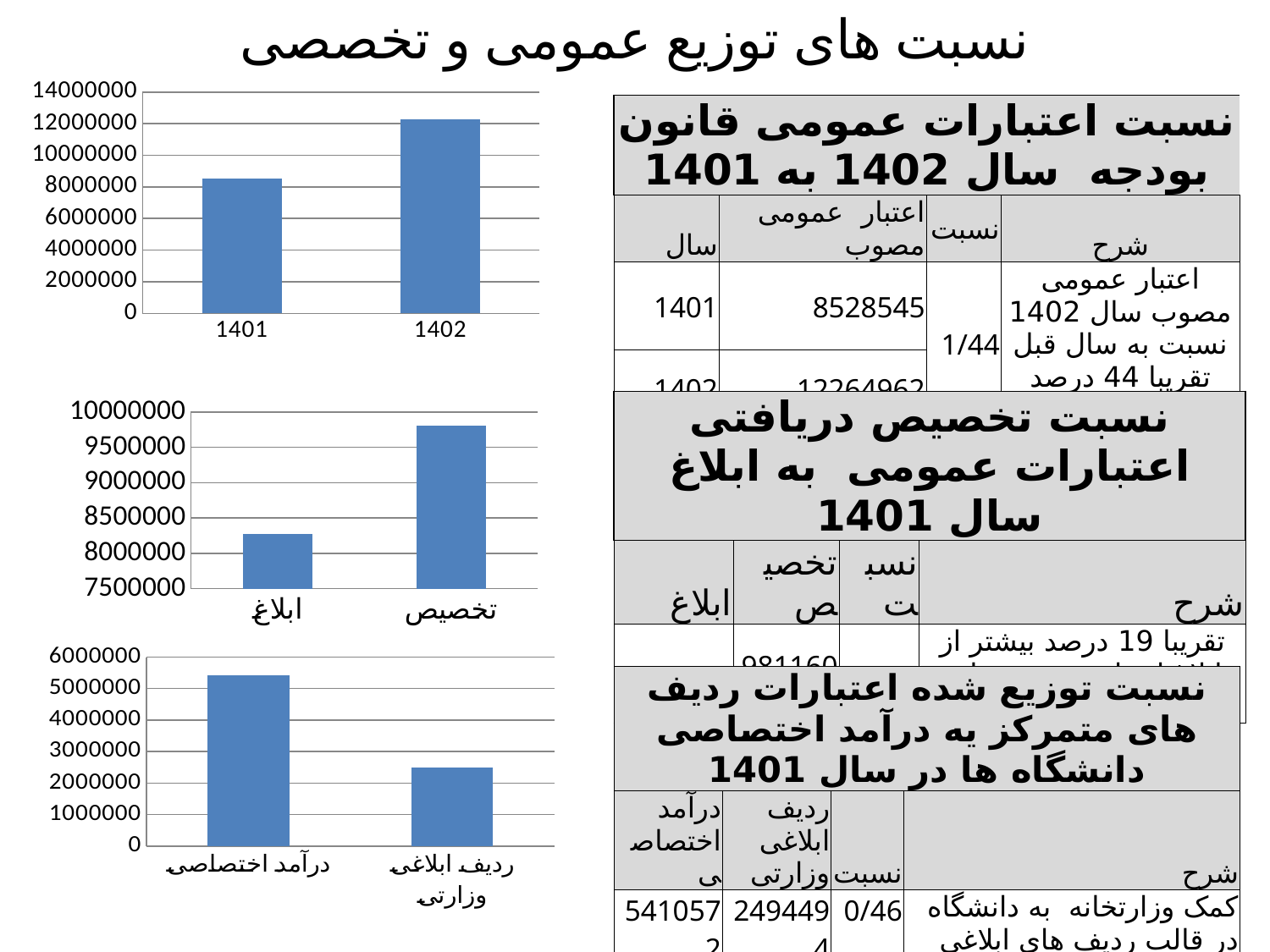
What kind of chart is the top-left chart? bar chart In the middle-left chart, is the value for ابلاغ greater or less than 8500000? less In the bottom-left chart, is the value for ردیف ابلاغی وزارتی greater or less than 3000000? less How many charts are shown on the slide? 3 In the middle-left chart, which category has the lowest value? ابلاغ In the top-left chart, how many categories are shown on the x axis? 2 In the middle-left chart, is the value for تخصیص greater or less than 9500000? greater In the bottom-left chart, which is larger: درآمد اختصاصی or ردیف ابلاغی وزارتی? درآمد اختصاصی In the top-left chart, which category has the highest value? 1402 In the top-left chart, do the values rise or fall from 1401 to 1402? rise